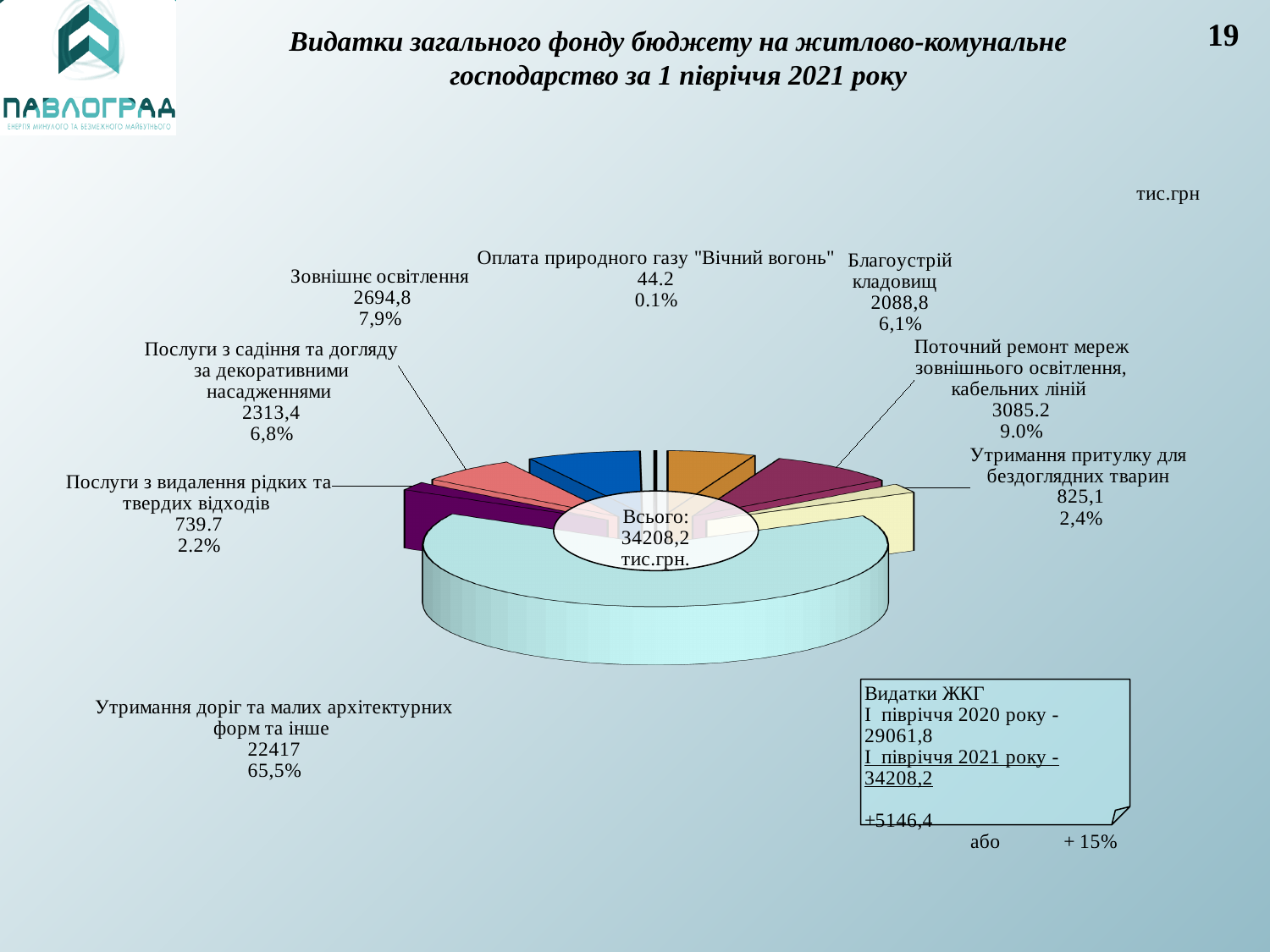
What is the difference between the values for "Поточний ремонт мереж зовнішнього освітлення, кабельних ліній" and "Зовнішнє освітлення"? 390.4 What is the value for "Благоустрій кладовищ"? 2088,8 What share of the pie does "Утримання доріг та малих архітектурних форм та інше" represent? 65,5% What total is shown in the centre of the pie chart? 34208,2 тис.грн. Which category has the largest value? Утримання доріг та малих архітектурних форм та інше What kind of chart is shown on the slide? pie chart What share of the pie does "Поточний ремонт мереж зовнішнього освітлення, кабельних ліній" represent? 9.0% What is the value for "Зовнішнє освітлення"? 2694,8 How many categories (slices) does the pie chart show? 8 Which is larger: "Послуги з садіння та догляду за декоративними насадженнями" or "Благоустрій кладовищ"? Послуги з садіння та догляду за декоративними насадженнями What is the value for "Утримання притулку для бездоглядних тварин"? 825,1 Which category has the smallest value? Оплата природного газу "Вічний вогонь"